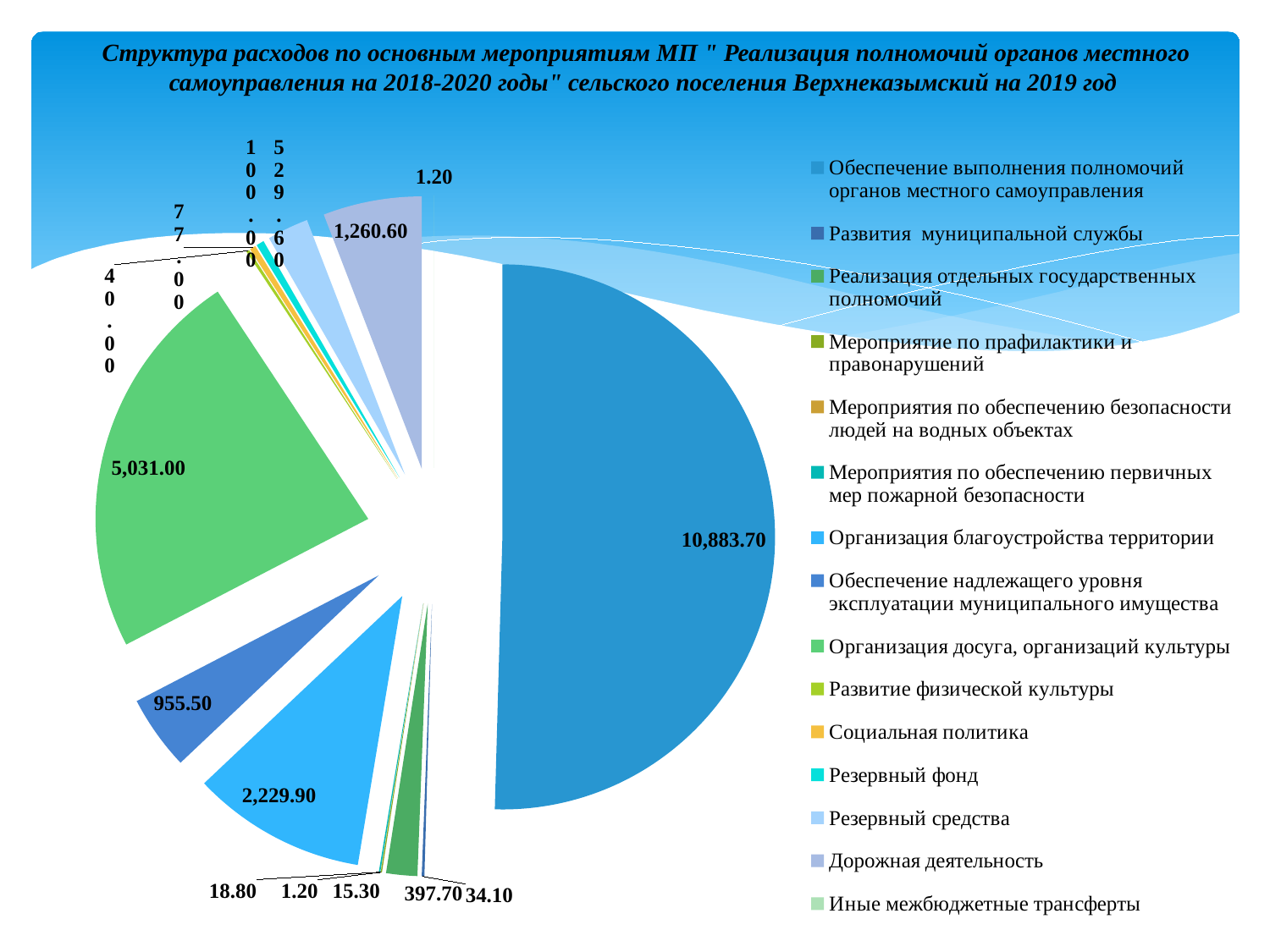
Which year does the chart title say the expenditure structure refers to? 2019 What is the value shown for "Дорожная деятельность"? 1,260.60 What is the difference between the slice labelled 2,229.90 and the slice labelled 955.50? 1,274.40 What is the value shown for "Обеспечение выполнения полномочий органов местного самоуправления"? 10,883.70 What is the difference between the slice labelled 10,883.70 and the slice labelled 5,031.00? 5,852.70 What is the value shown for "Организация благоустройства территории"? 2,229.90 What is the value shown for "Организация досуга, организаций культуры"? 5,031.00 What is the value of the largest slice of the pie chart? 10,883.70 What kind of chart is shown on the slide? pie chart How many entries does the legend of the pie chart list? 15 What is the value shown for "Обеспечение надлежащего уровня эксплуатации муниципального имущества"? 955.50 Which is larger: the slice labelled 5,031.00 or the slice labelled 2,229.90? 5,031.00